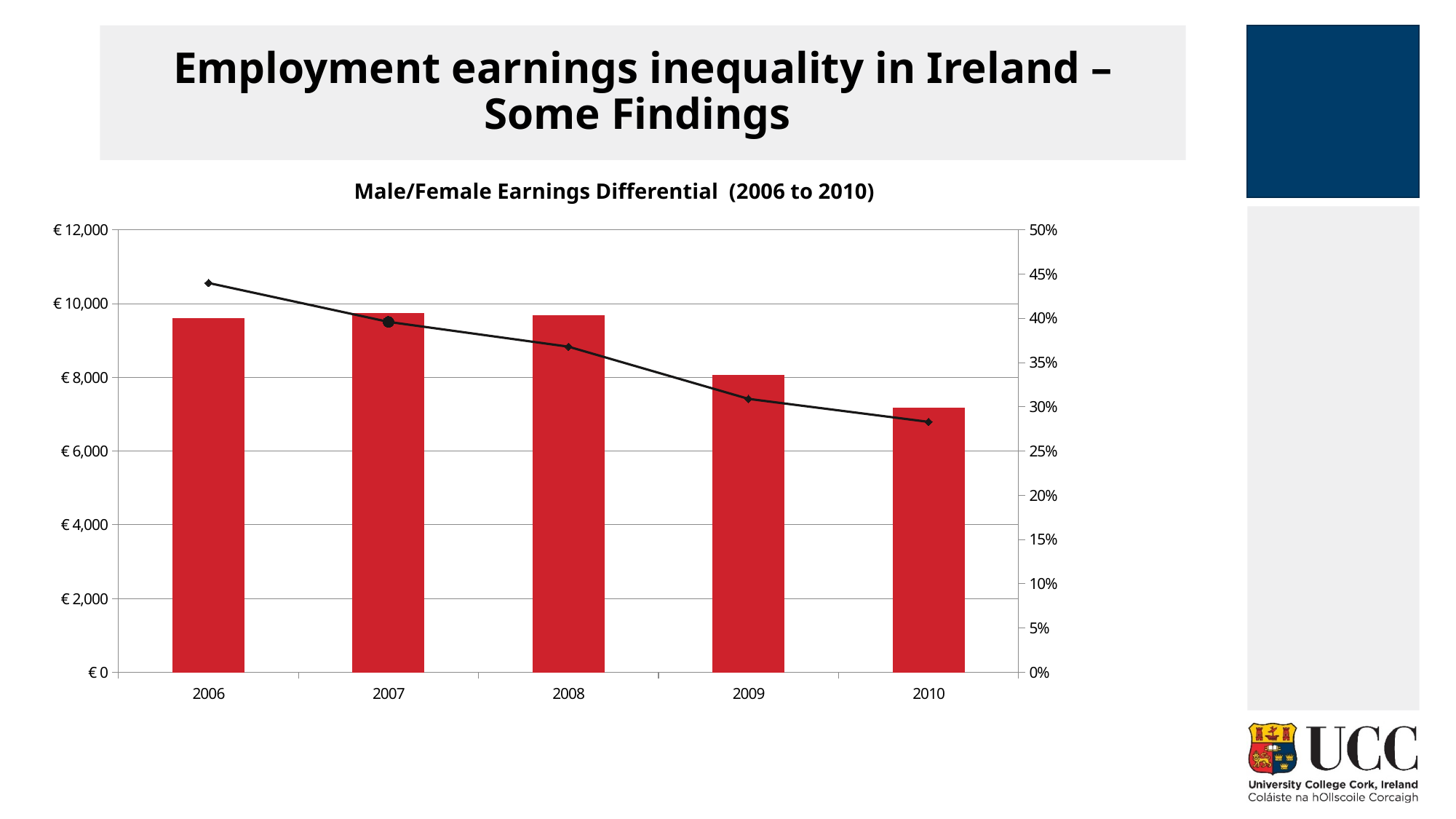
In which year is the line series at its highest point? 2006 What is the title of the chart? Male/Female Earnings Differential (2006 to 2010) What kind of chart is shown on the slide? A bar chart combined with a line chart Which year has the lowest bar in the chart? 2010 Is the bar value for 2006 greater or less than €10,000? less In which year is the line series at its lowest point? 2010 Is the line value for 2010 greater or less than 30%? less Does the line series rise or fall from 2006 to 2010? It falls How many years are shown on the x axis of the chart? 5 Is the bar value for 2010 greater or less than €8,000? less Which year has the larger bar, 2006 or 2010? 2006